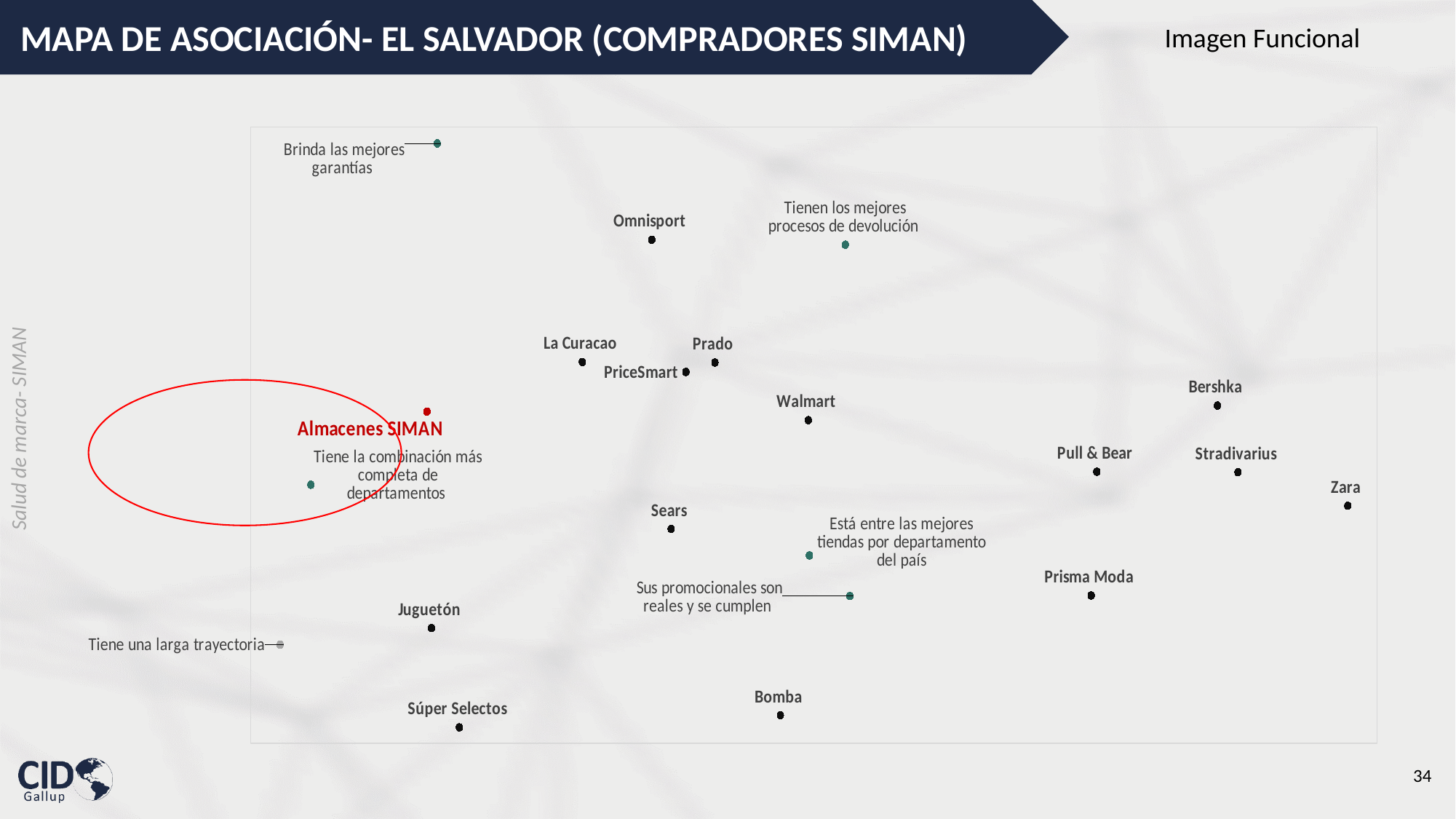
Which brand is positioned farthest to the right on the map? Zara Which attribute is positioned at the very top of the map? Brinda las mejores garantías Which brand is positioned highest on the map? Omnisport Which attribute is enclosed in the red circle together with Almacenes SIMAN? Tiene la combinación más completa de departamentos Which attribute is closest to Omnisport on the map? Tienen los mejores procesos de devolución How many attribute statements (green/grey points) are plotted on the map? 6 Which brand is closest to the attribute 'Tiene una larga trayectoria'? Juguetón Which brand is positioned lowest on the map? Súper Selectos Which brand is highlighted in red on the map? Almacenes SIMAN What kind of chart is shown on the slide? Scatter plot (association map) How many brands are plotted on the association map? 15 What is the title of the slide containing the map? MAPA DE ASOCIACIÓN- EL SALVADOR (COMPRADORES SIMAN)